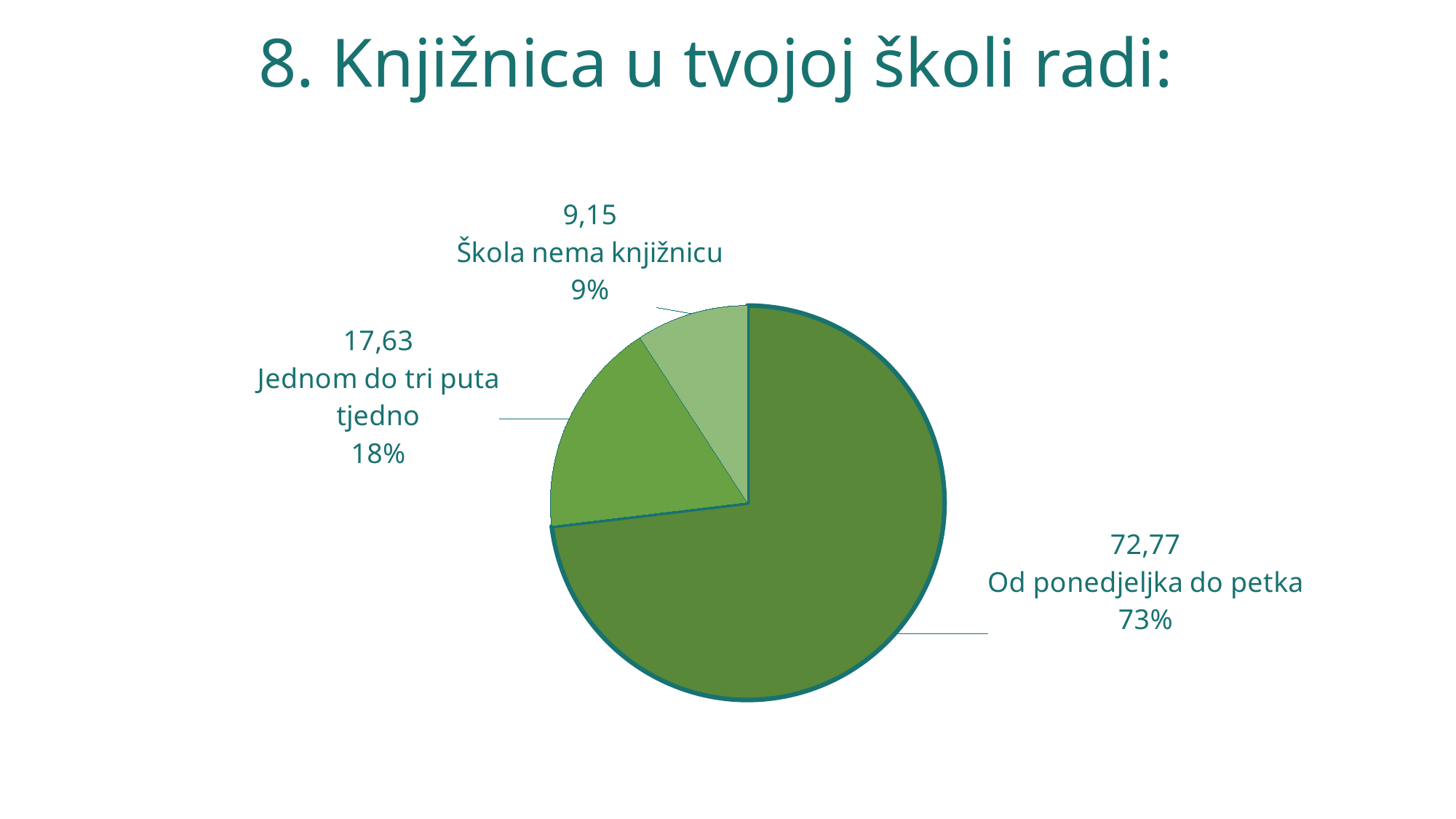
Which category has the smallest slice of the pie? Škola nema knjižnicu Which category has the largest slice of the pie? Od ponedjeljka do petka What is the value shown for "Škola nema knjižnicu"? 9,15 What is the value shown for "Od ponedjeljka do petka"? 72,77 What percentage share of the pie does "Škola nema knjižnicu" have? 9% How many slices does the pie chart have? 3 What percentage share of the pie does "Od ponedjeljka do petka" have? 73% What is the title of the slide containing the pie chart? 8. Knjižnica u tvojoj školi radi: What percentage share of the pie does "Jednom do tri puta tjedno" have? 18% Which is larger: the value for "Jednom do tri puta tjedno" or for "Škola nema knjižnicu"? Jednom do tri puta tjedno What kind of chart is shown on the slide? pie chart What is the value shown for "Jednom do tri puta tjedno"? 17,63